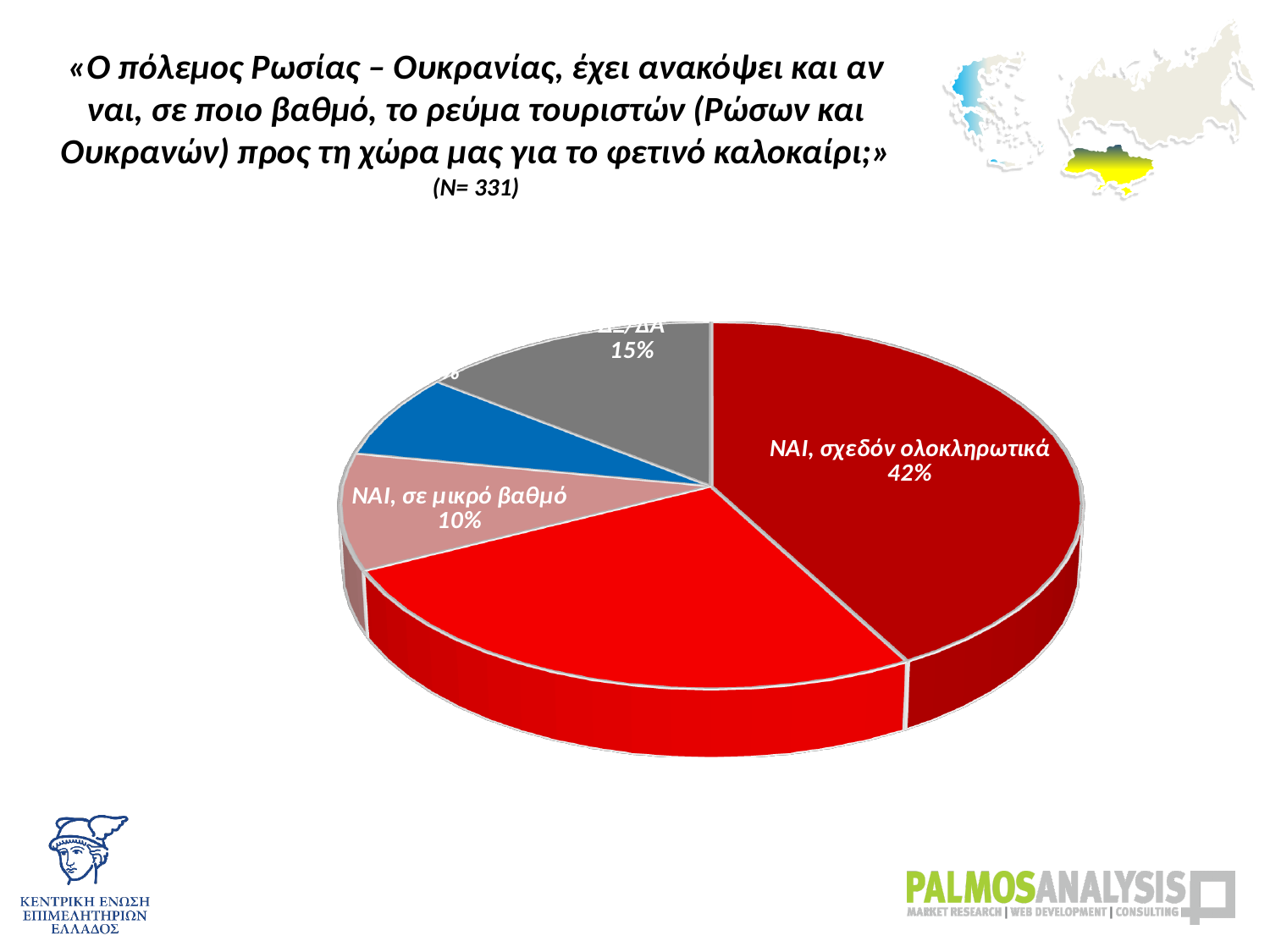
What colour is the slice labelled "ΝΑΙ, σχεδόν ολοκληρωτικά"? dark red Which slice of the pie chart is the largest? ΝΑΙ, σχεδόν ολοκληρωτικά What is the difference in percentage points between the "ΔΞ/ΔΑ" slice and the "ΝΑΙ, σε μικρό βαθμό" slice? 5 percentage points What percentage is shown for the slice labelled "ΝΑΙ, σε μικρό βαθμό"? 10% What percentage is shown for the slice labelled "ΔΞ/ΔΑ"? 15% What kind of chart is shown on the slide? pie chart What percentage is shown for the slice labelled "ΝΑΙ, σχεδόν ολοκληρωτικά"? 42% How many slices does the pie chart have? 5 What is the difference in percentage points between the "ΝΑΙ, σχεδόν ολοκληρωτικά" slice and the "ΔΞ/ΔΑ" slice? 27 percentage points Which is larger: the "ΝΑΙ, σχεδόν ολοκληρωτικά" slice or the "ΔΞ/ΔΑ" slice? ΝΑΙ, σχεδόν ολοκληρωτικά Which is larger: the "ΔΞ/ΔΑ" slice or the "ΝΑΙ, σε μικρό βαθμό" slice? ΔΞ/ΔΑ What sample size (N) is stated under the question title on the slide? N= 331